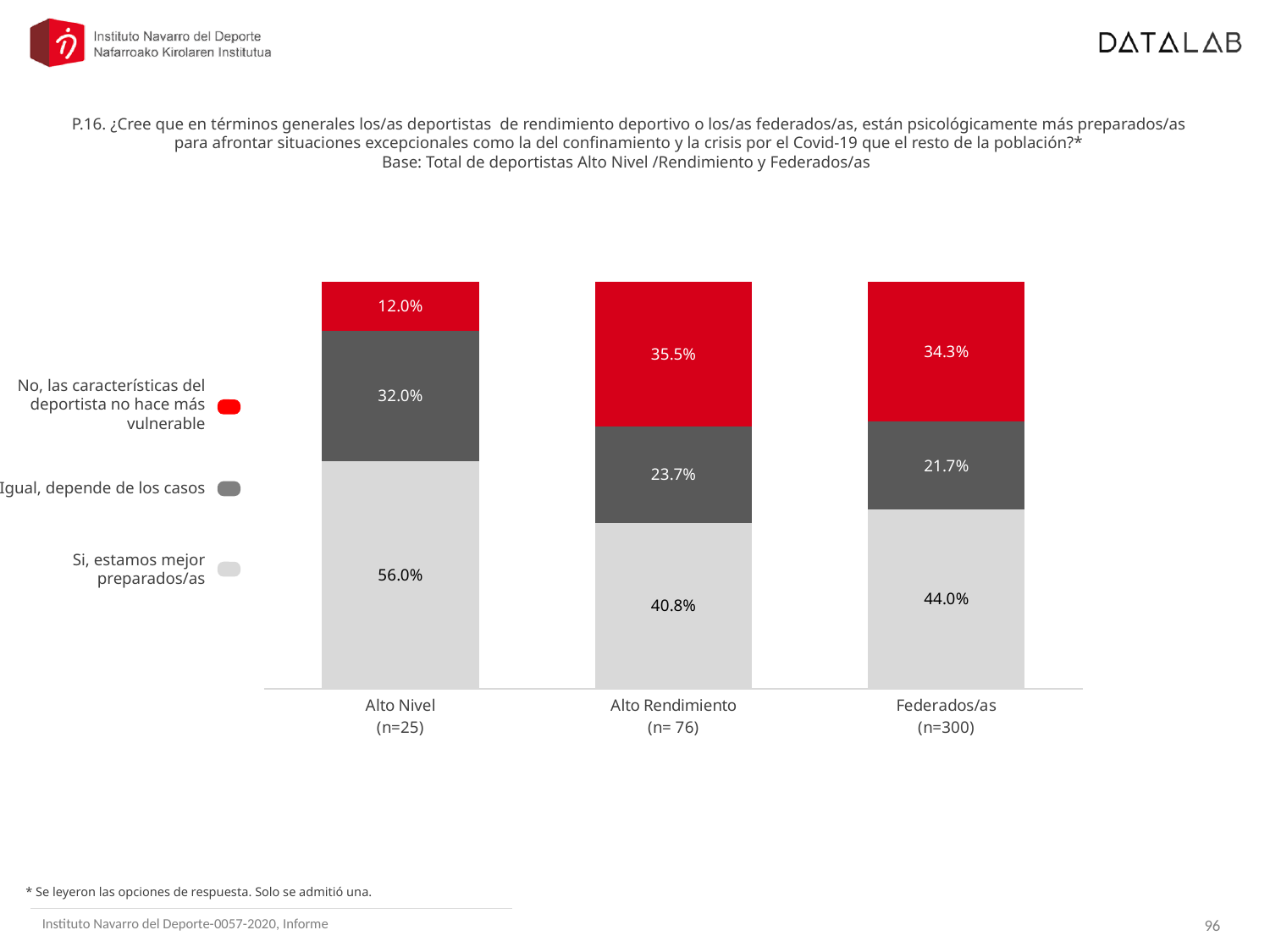
How many categories (groups of athletes) are shown on the x axis? 3 What is the value for 'Igual, depende de los casos' in the Alto Rendimiento (n= 76) group? 23.7% Which group has the lowest value for 'No, las características del deportista no hace más vulnerable'? Alto Nivel (n=25) Which colour represents 'No, las características del deportista no hace más vulnerable' in the legend? Red What is the value for 'No, las características del deportista no hace más vulnerable' in the Federados/as (n=300) group? 34.3% How many series does the legend list? 3 What is the difference between the 'Si, estamos mejor preparados/as' values for Alto Nivel and Alto Rendimiento? 15.2% Which group has the highest value for 'Si, estamos mejor preparados/as'? Alto Nivel (n=25) What kind of chart is shown on the slide? Stacked bar chart What is the total of the stacked bar for Federados/as (n=300)? 100.0% Which is larger: the 'Igual, depende de los casos' value for Alto Rendimiento or for Federados/as? Alto Rendimiento What is the value for 'Si, estamos mejor preparados/as' in the Alto Nivel (n=25) group? 56.0%